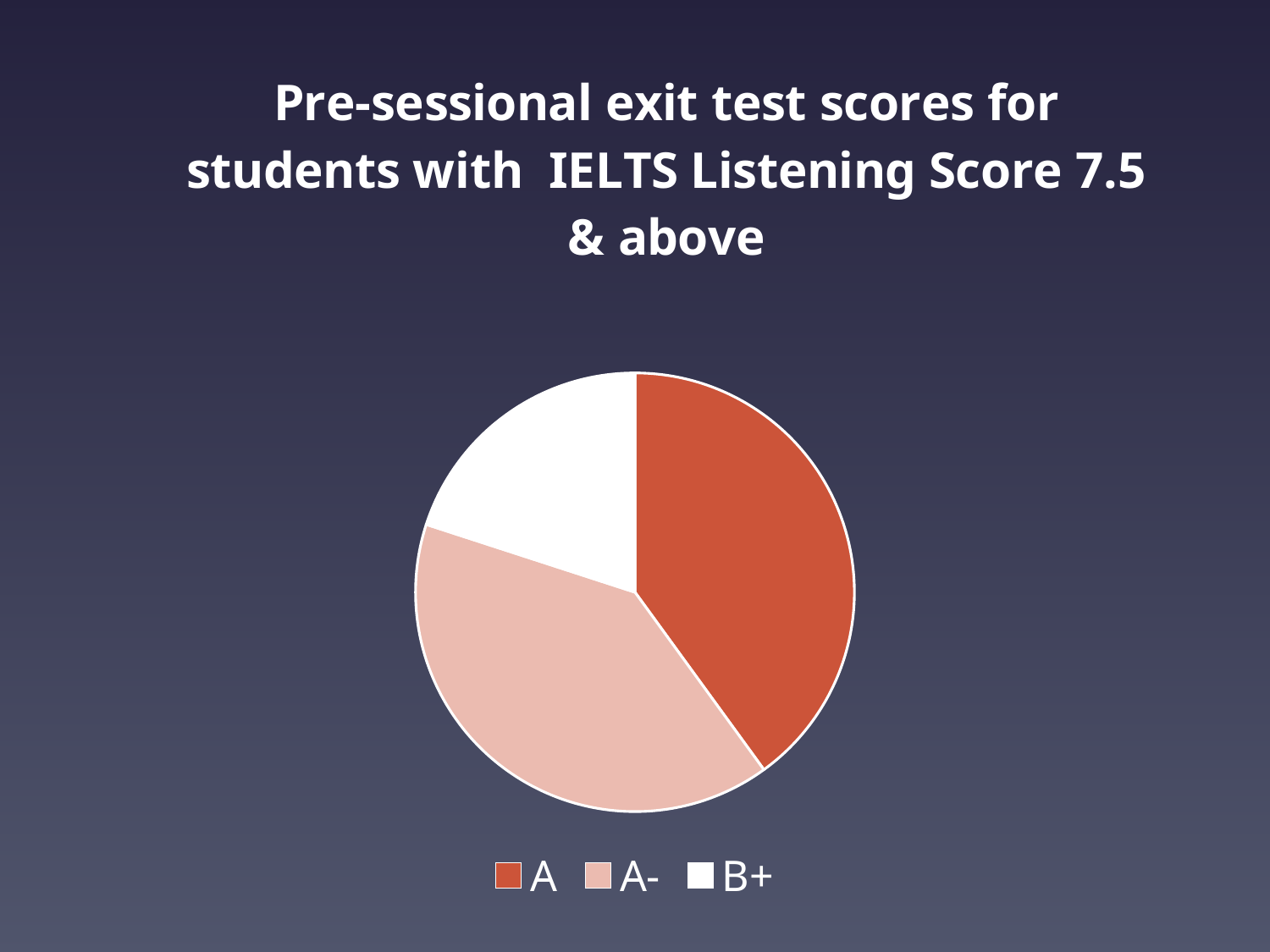
Which category is shown in white in the pie chart? B+ Which category has the smallest slice of the pie? B+ How many slices does the pie chart have? 3 Which slice is larger, A or B+? A Which slice is larger, A- or B+? A- What is the title of the chart? Pre-sessional exit test scores for students with IELTS Listening Score 7.5 & above How many entries does the legend list? 3 What kind of chart is shown on the slide? pie chart